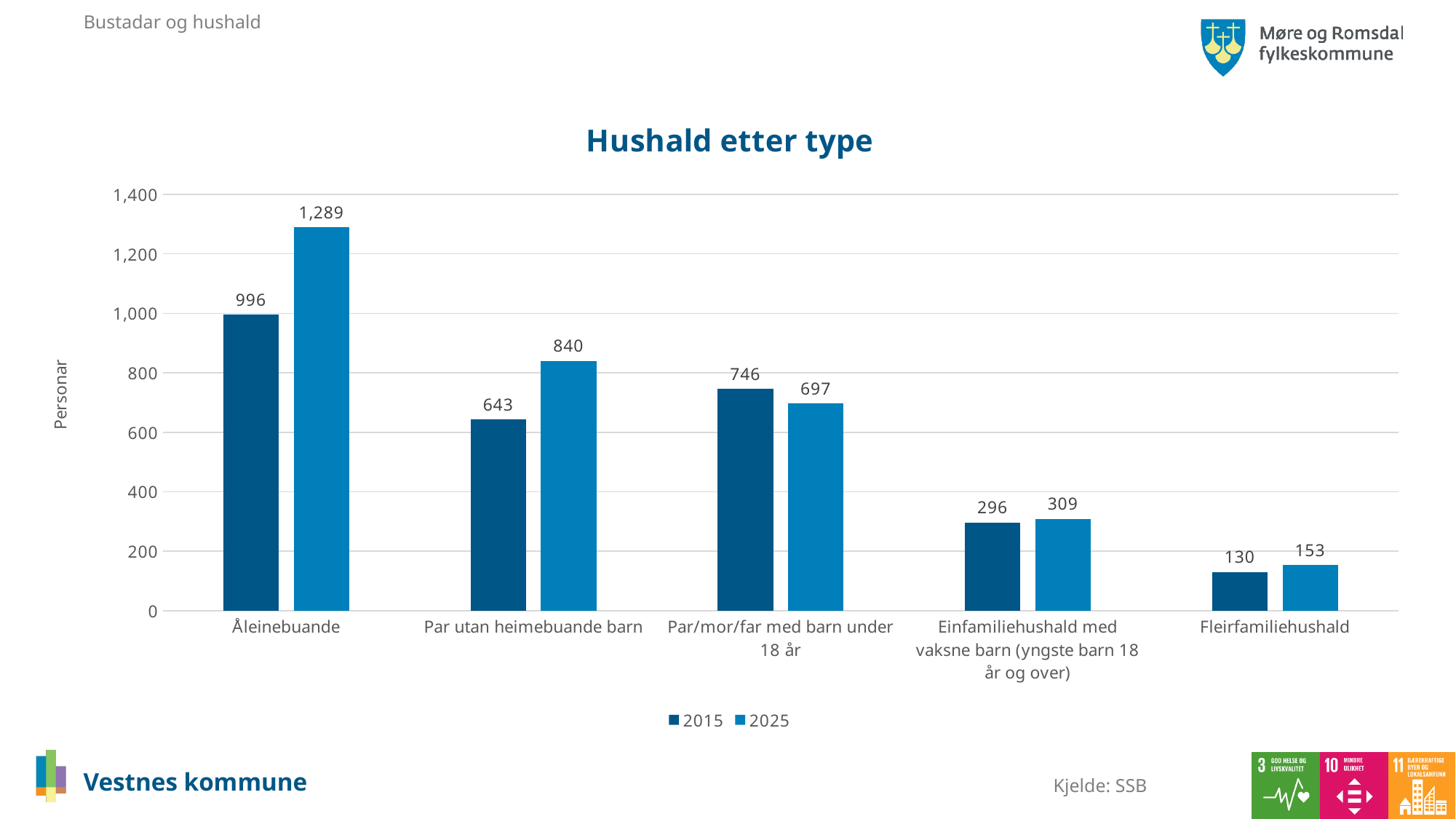
Which category has the lowest 2015 value? Fleirfamiliehushald What is the 2025 value for Åleinebuande? 1,289 Is the 2015 value for Einfamiliehushald med vaksne barn (yngste barn 18 år og over) greater or less than 400? less What is the 2025 value for Fleirfamiliehushald? 153 What is the difference between the 2015 and 2025 values for Par/mor/far med barn under 18 år? 49 What type of chart is shown? bar chart What is the 2015 value for Par/mor/far med barn under 18 år? 746 For Par utan heimebuande barn, which year has the larger value, 2015 or 2025? 2025 How many household categories are shown on the x axis? 5 Which category has the highest 2025 value? Åleinebuande What is the difference between the 2025 and 2015 values for Åleinebuande? 293 How many series does the legend list? 2